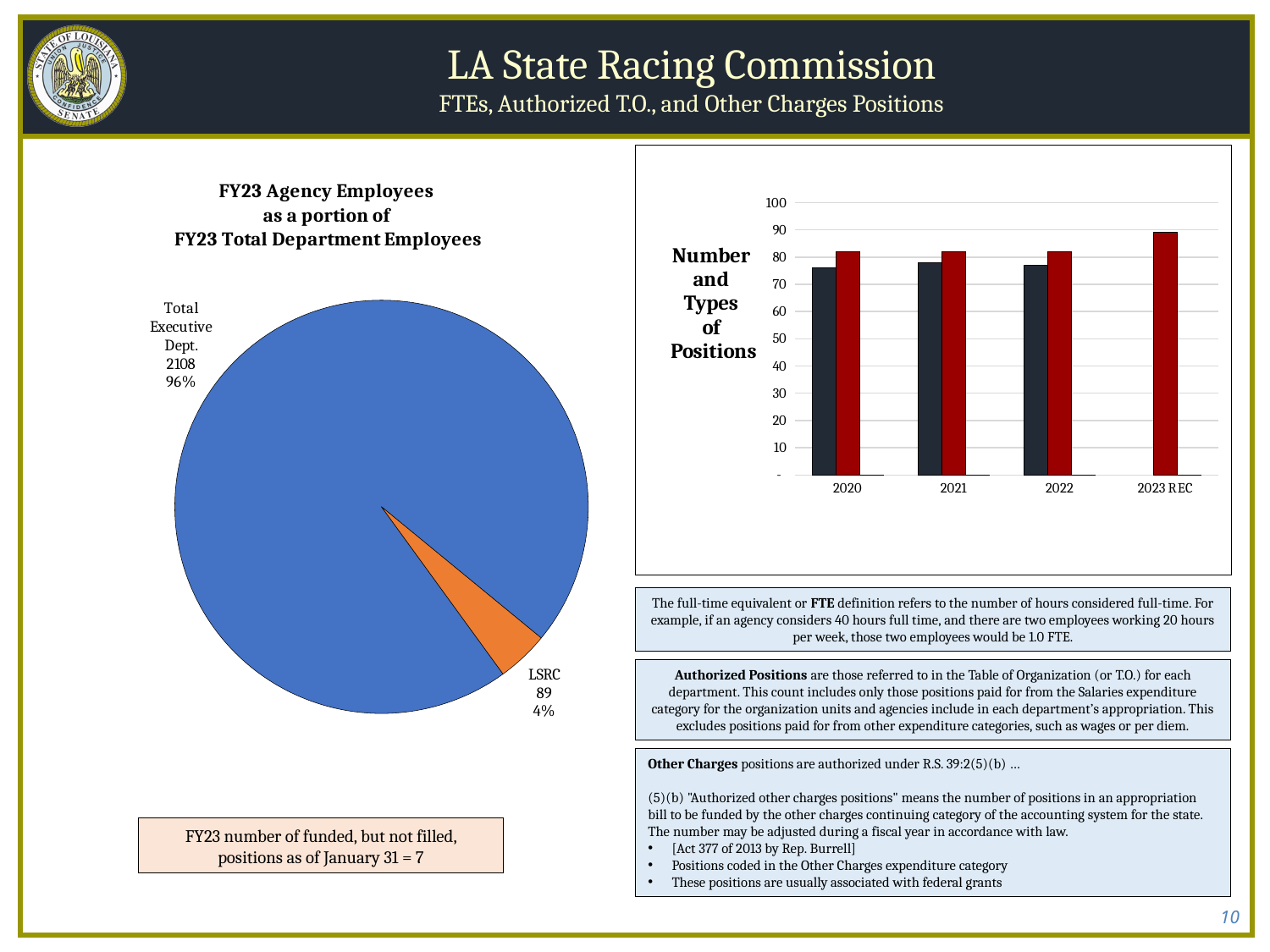
In the pie chart 'FY23 Agency Employees as a portion of FY23 Total Department Employees', what share of the pie does LSRC represent? 4% In the 'Number and Types of Positions' bar chart, is the dark bar for 2020 greater or less than 80? less In the pie chart 'FY23 Agency Employees as a portion of FY23 Total Department Employees', how many slices are there? 2 In the pie chart 'FY23 Agency Employees as a portion of FY23 Total Department Employees', what is the value for LSRC? 89 In the 'Number and Types of Positions' bar chart, is the red bar for 2023 REC greater or less than 80? greater In the 'Number and Types of Positions' bar chart, how many year categories are shown on the x axis? 4 In the pie chart 'FY23 Agency Employees as a portion of FY23 Total Department Employees', what is the value for Total Executive Dept.? 2108 What kind of chart is the 'Number and Types of Positions' chart on the right of the slide? Bar chart In the pie chart 'FY23 Agency Employees as a portion of FY23 Total Department Employees', what is the difference between the Total Executive Dept. value and the LSRC value? 2019 In the pie chart 'FY23 Agency Employees as a portion of FY23 Total Department Employees', which slice is the largest? Total Executive Dept. In the pie chart 'FY23 Agency Employees as a portion of FY23 Total Department Employees', what share of the pie does Total Executive Dept. represent? 96% In the 'Number and Types of Positions' bar chart, which year has the tallest red bar? 2023 REC